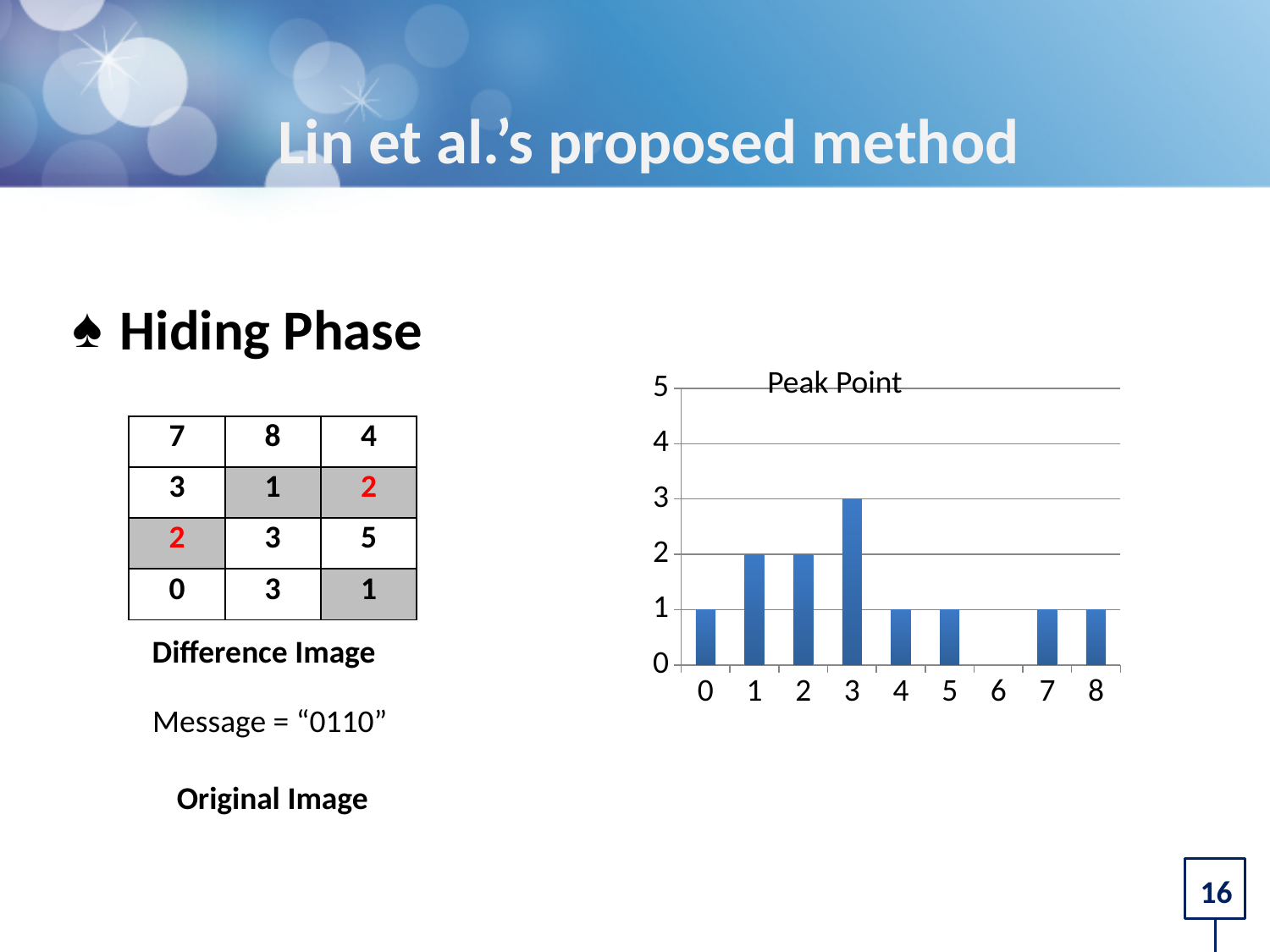
What is the value of the bar for category 8? 1 What is the difference between the values for category 3 and category 4? 2 Is the value for category 3 greater or less than 2? greater Which category has the highest bar? 3 How many categories are shown on the x axis? 9 What text label appears at the top of the chart? Peak Point What is the value of the bar for category 3? 3 What is the value of the bar for category 1? 2 Which category has the lowest bar? 6 What is the value of the bar for category 6? 0 What kind of chart is shown on the slide? bar chart Which is larger, the value for category 2 or the value for category 5? category 2